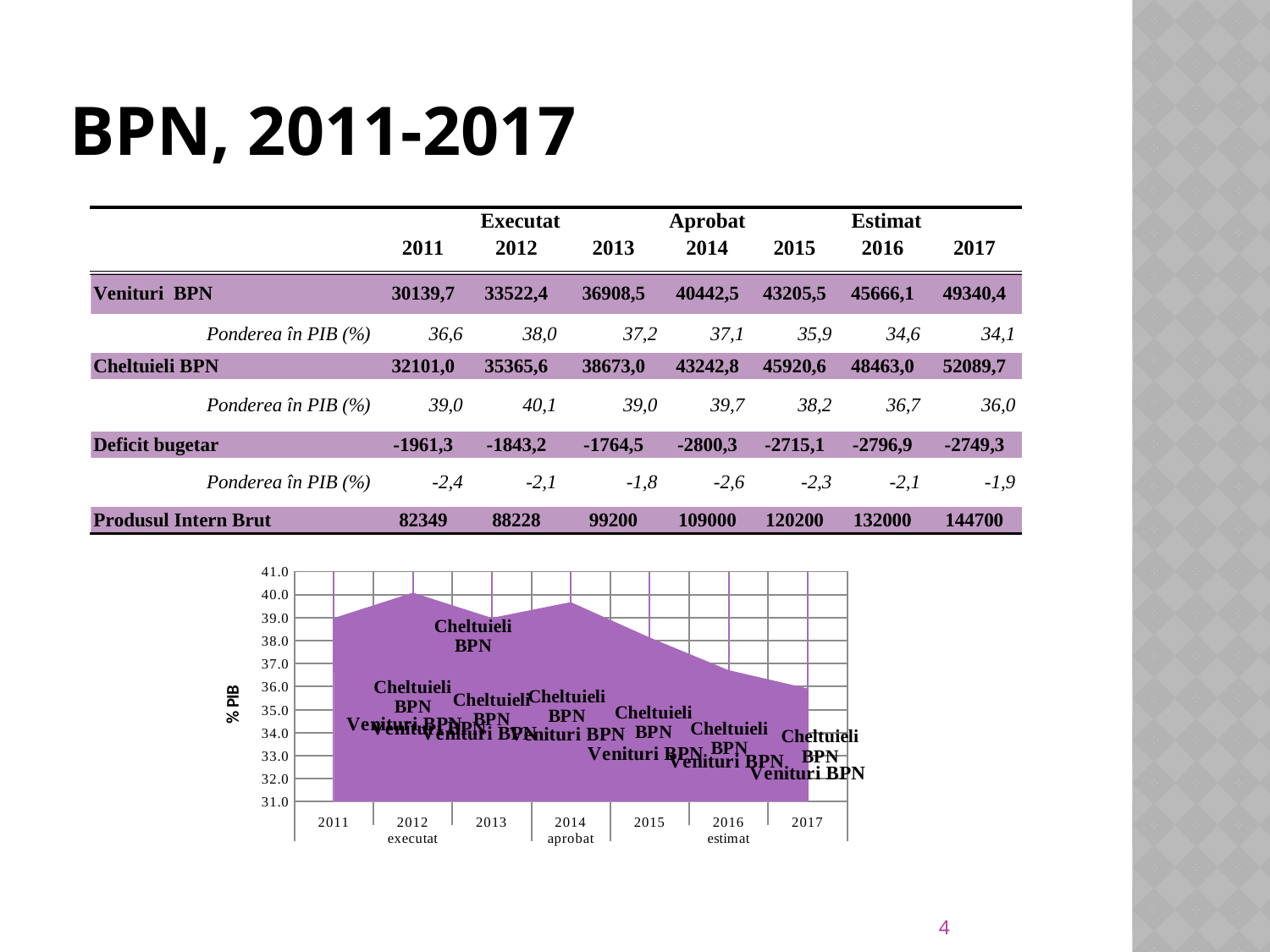
Is the plotted value for 2017 greater or less than 37.0? less Which year has the larger plotted value, 2011 or 2016? 2011 According to the slide, what is the Cheltuieli BPN share of PIB (Ponderea în PIB) in 2012? 40,1 What is the label on the vertical axis of the chart? % PIB What kind of chart is shown at the bottom of the slide? area chart In which year is the plotted Cheltuieli BPN share of PIB lowest on the chart? 2017 According to the slide, what is the difference between the Cheltuieli BPN share of PIB in 2012 and in 2017? 4,1 Does the plotted Cheltuieli BPN share of PIB rise or fall from 2014 to 2017? fall Is the plotted value for 2011 greater or less than 38.0? greater In which year does the plotted Cheltuieli BPN share of PIB reach its highest point on the chart? 2012 How many years are shown along the x axis of the chart? 7 Is the plotted value for 2016 greater or less than 38.0? less